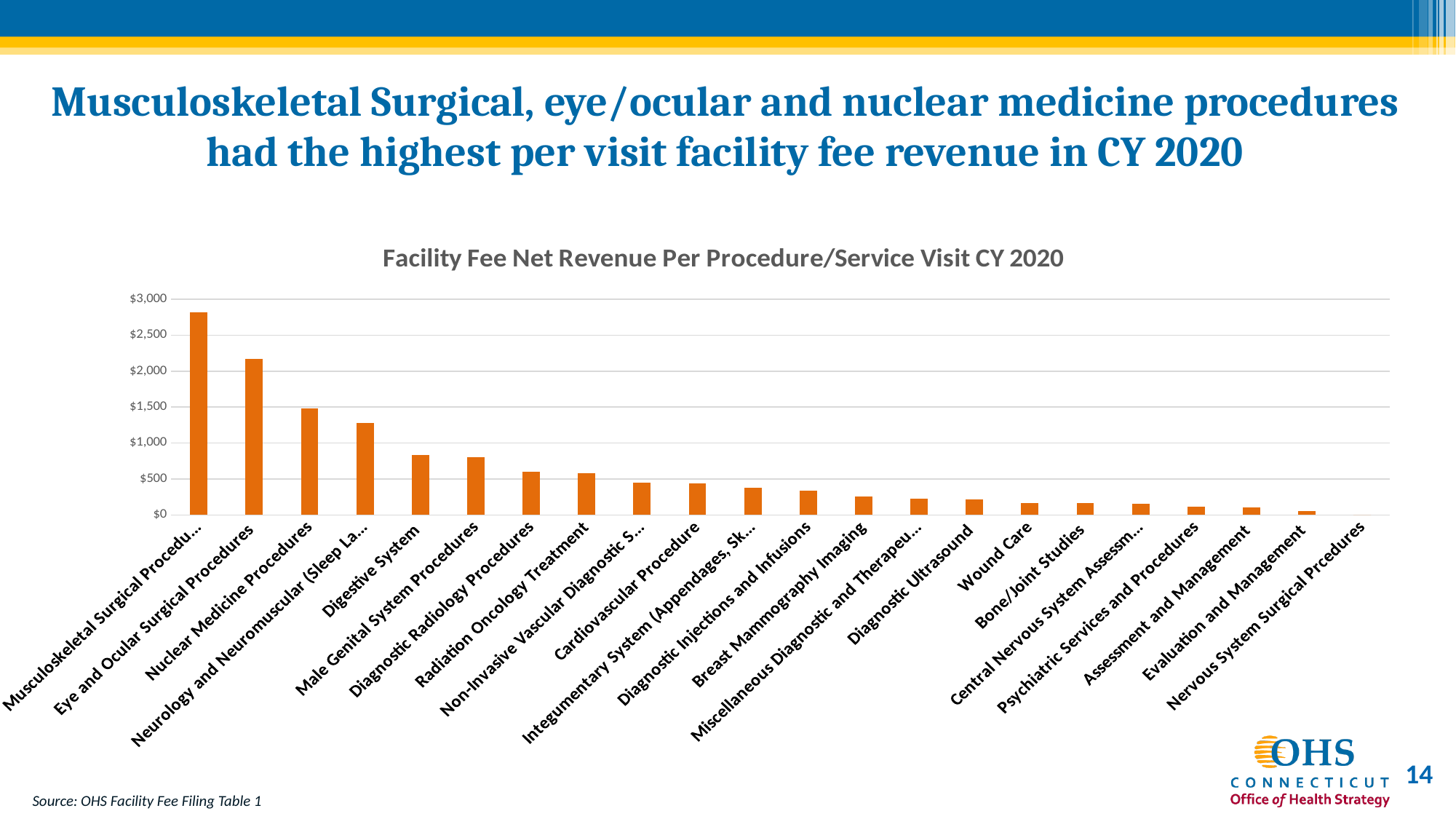
Do the values rise or fall moving from left to right along the x axis? fall What is the title of the chart? Facility Fee Net Revenue Per Procedure/Service Visit CY 2020 Which is larger, the value for Radiation Oncology Treatment or the value for Breast Mammography Imaging? Radiation Oncology Treatment Is the value for Digestive System greater or less than $1,000? less Is the value for Musculoskeletal Surgical Procedures greater or less than $2,500? greater Is the value for Eye and Ocular Surgical Procedures greater or less than $2,000? greater Which category has the highest facility fee net revenue per visit? Musculoskeletal Surgical Procedures What type of chart is shown on the slide? Bar chart Which is larger, the value for Eye and Ocular Surgical Procedures or the value for Nuclear Medicine Procedures? Eye and Ocular Surgical Procedures How many categories are shown on the x axis of the chart? 22